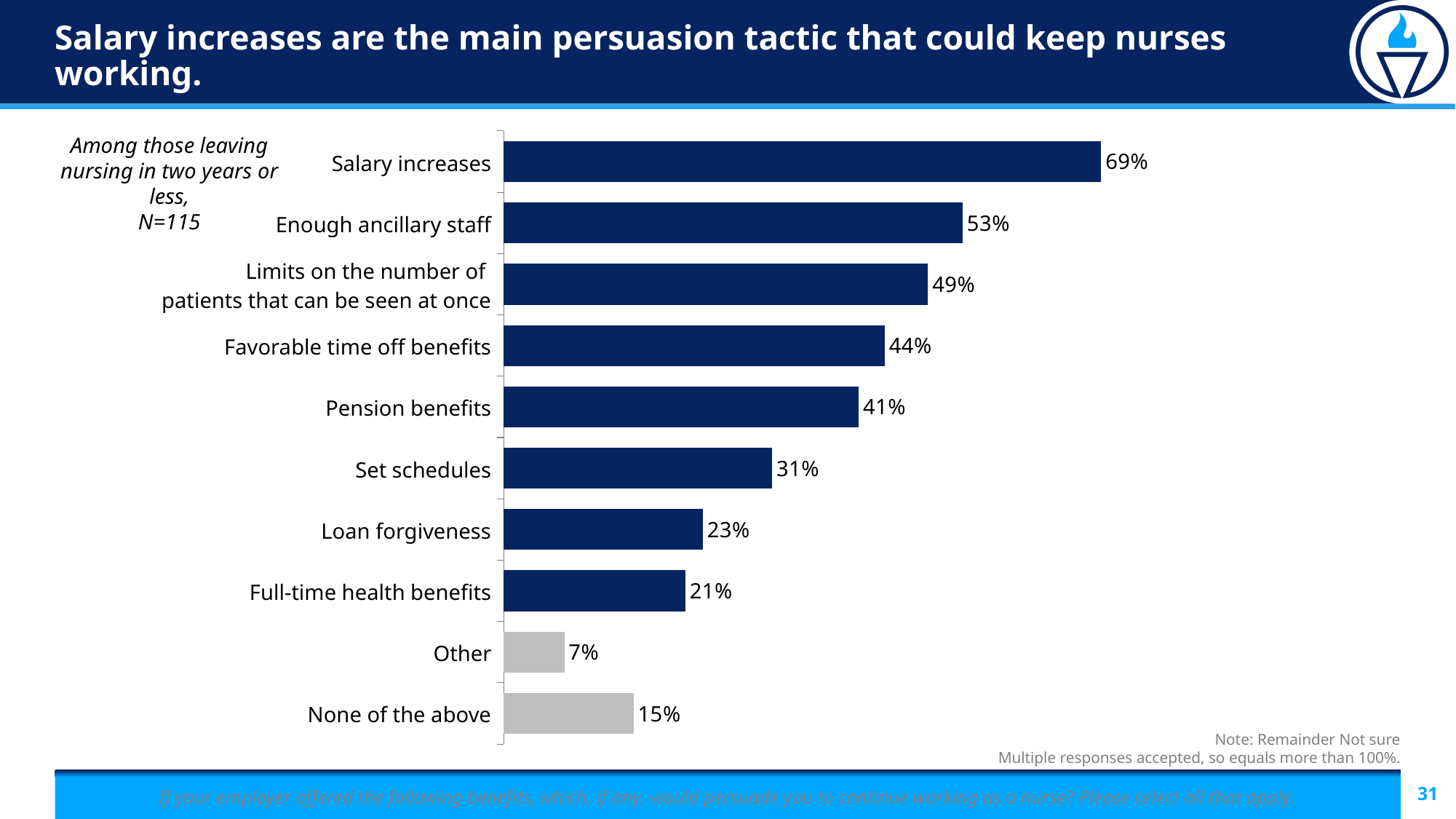
Which category has the lowest value? Other What kind of chart is shown on the slide? Bar chart What is the difference between Set schedules and Full-time health benefits? 10% Which is larger, None of the above or Other? None of the above Which is larger, Favorable time off benefits or Pension benefits? Favorable time off benefits What percentage of respondents selected Salary increases? 69% What percentage selected Loan forgiveness? 23% What is the sample size (N) noted on the slide? N=115 What is the value for Pension benefits? 41% Which category has the highest value? Salary increases What is the difference between Salary increases and Enough ancillary staff? 16% How many categories are shown in the chart? 10